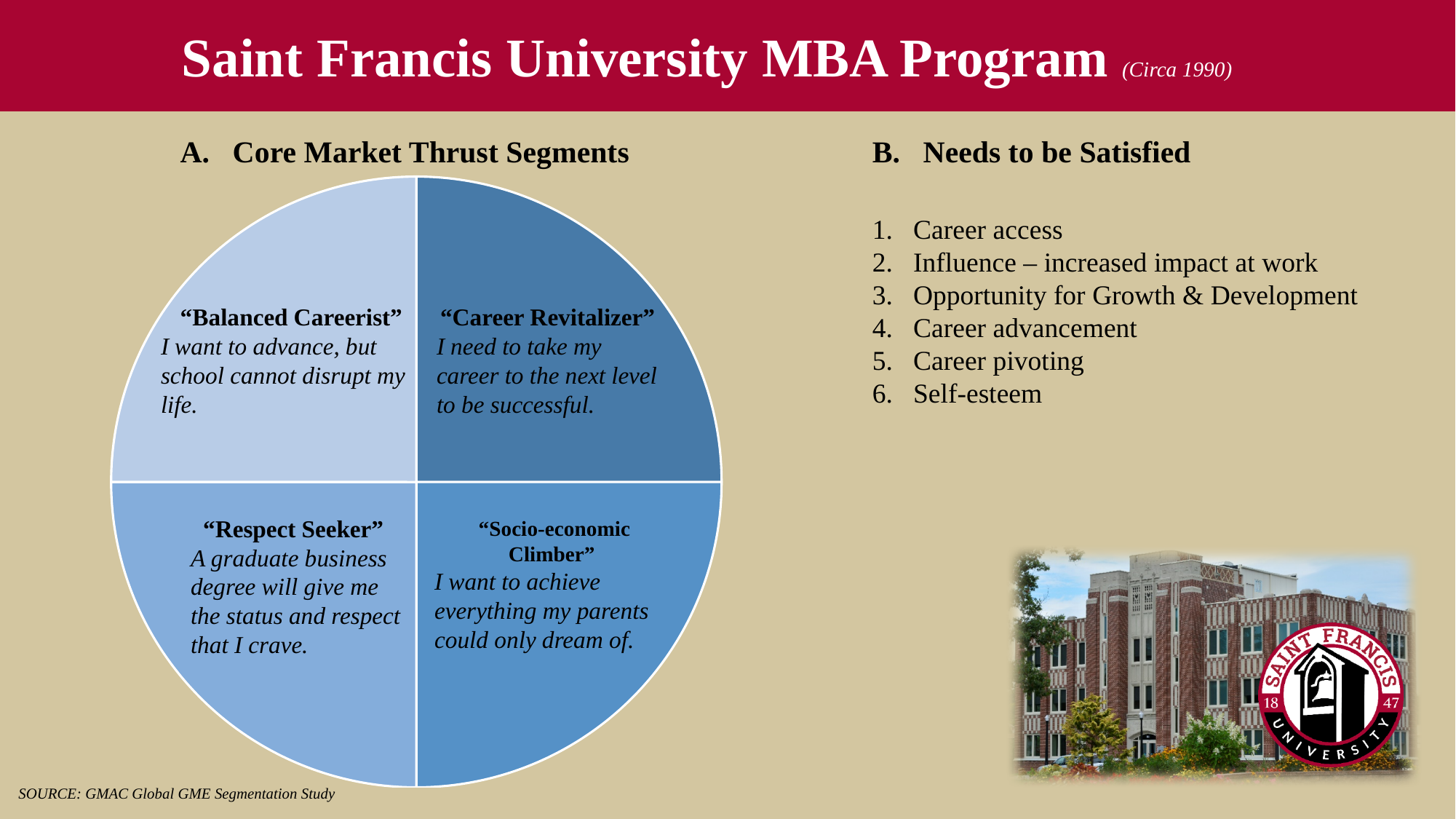
Which segment of the pie chart is described with the statement "A graduate business degree will give me the status and respect that I crave."? "Respect Seeker" Which segment of the pie chart is in the top-right quadrant? "Career Revitalizer" Which segment of the pie chart is described with the statement "I want to advance, but school cannot disrupt my life."? "Balanced Careerist" Which segment of the pie chart is in the top-left quadrant? "Balanced Careerist" What kind of chart is shown under "A. Core Market Thrust Segments"? Pie chart How many segments does the pie chart under "A. Core Market Thrust Segments" have? 4 What source is cited for the pie chart at the bottom of the slide? GMAC Global GME Segmentation Study Are the four segments of the pie chart shown as equal in size? Yes Which segment of the pie chart is described with the statement "I need to take my career to the next level to be successful."? "Career Revitalizer" Which segment of the pie chart is in the bottom-right quadrant? "Socio-economic Climber" Which segment of the pie chart is in the bottom-left quadrant? "Respect Seeker" Which segment of the pie chart is described with the statement "I want to achieve everything my parents could only dream of."? "Socio-economic Climber"